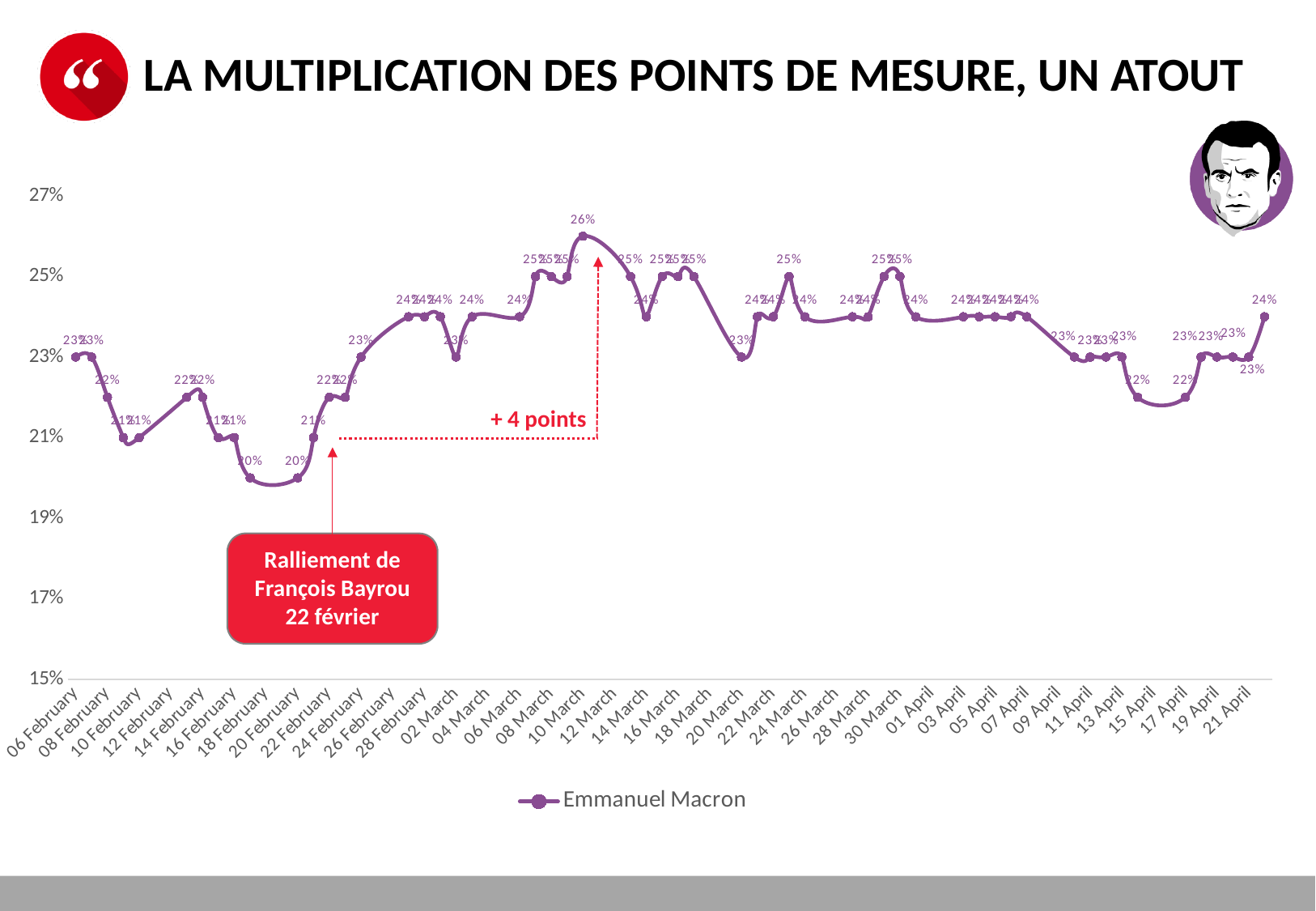
What is the difference between the highest labelled value (26%) and the lowest labelled value (20%)? 6 percentage points Is the value for Emmanuel Macron around 18 February greater or less than 21%? less What kind of chart is shown on the slide? line chart What is the value for Emmanuel Macron on 06 February? 23% What is the lowest value labelled on the line? 20% Do the values rise or fall between 06 February and 18 February? fall What gain does the red dotted annotation on the chart indicate? + 4 points What is the name of the series shown in the legend? Emmanuel Macron What is the highest value labelled on the line? 26% How many series does the legend list? 1